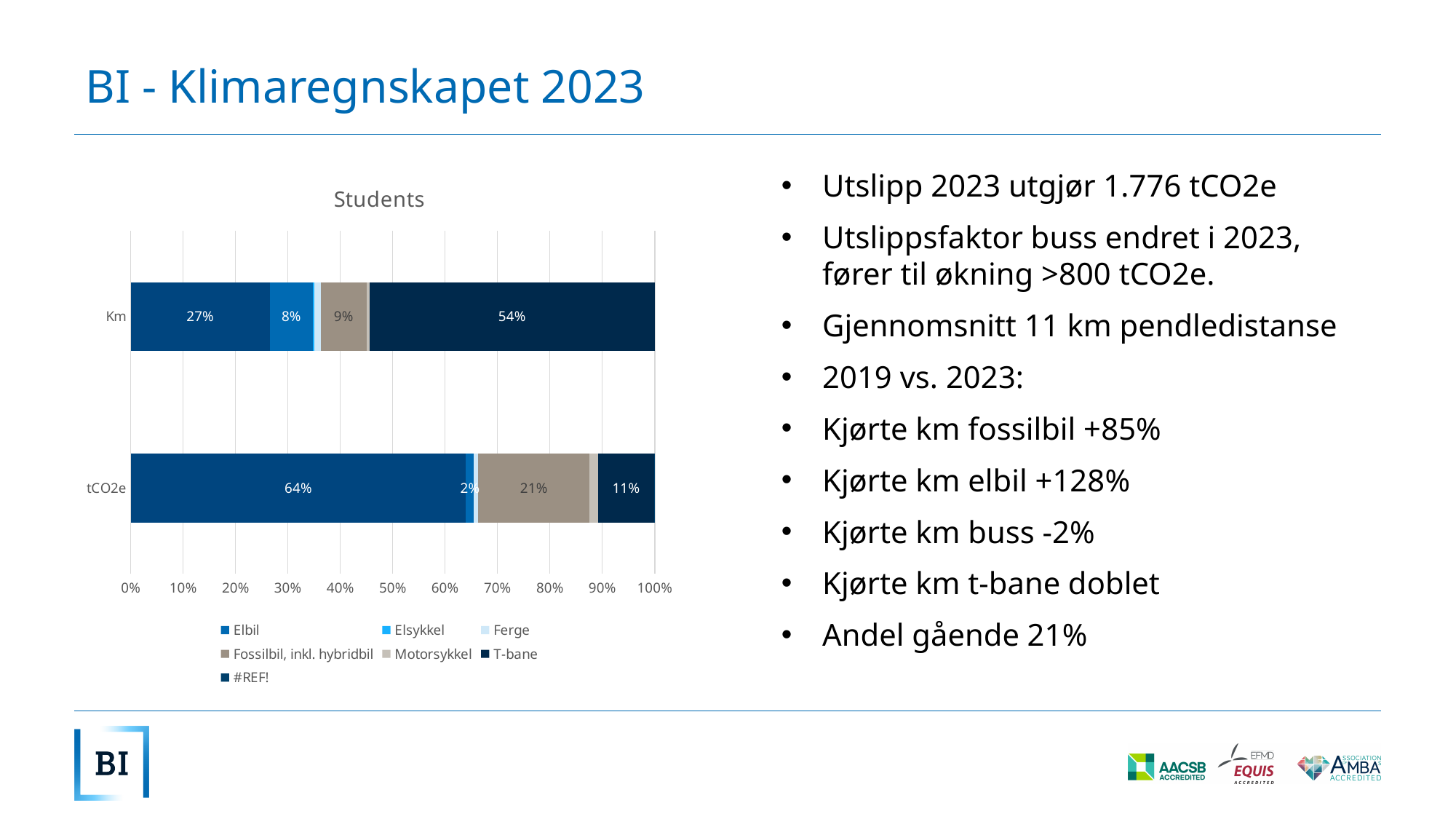
What is the Elbil share of the tCO2e bar? 2% What is the T-bane share of the Km bar? 54% What is the Fossilbil, inkl. hybridbil share of the tCO2e bar? 21% What type of chart is shown on the slide? Stacked bar chart What is the title of the chart? Students Is the T-bane share larger in the Km bar or in the tCO2e bar? Km Which series has the largest share of the Km bar? T-bane What is the Elbil share of the Km bar? 8% What is the difference between the Elbil share in the tCO2e bar and the Elbil share in the Km bar? 6% How many categories (bars) does the chart show? 2 How many series does the legend list? 7